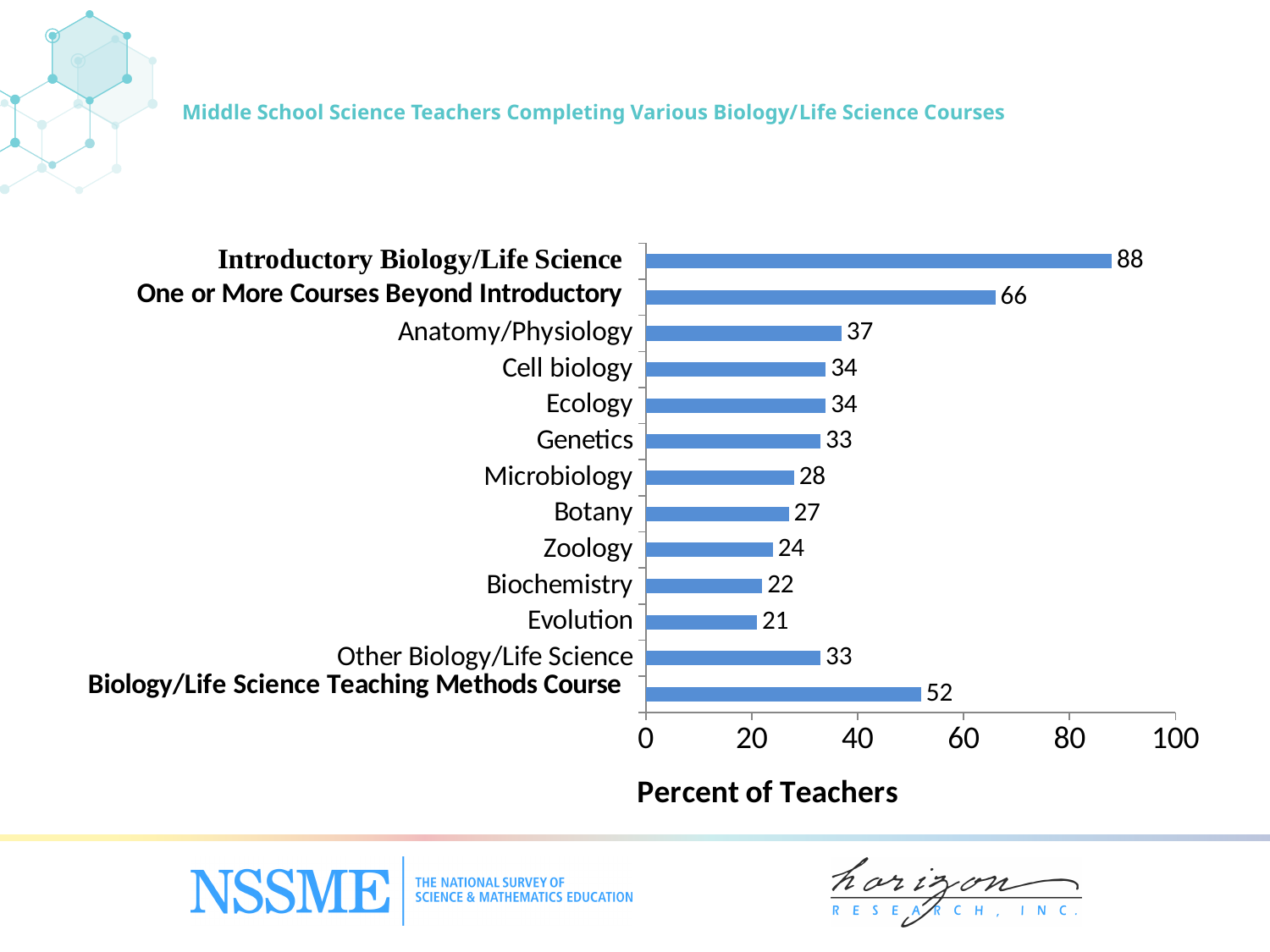
Which course has the lowest percent of teachers? Evolution What percent of teachers completed a Biology/Life Science Teaching Methods Course? 52 What kind of chart is shown on the slide? bar chart What is the value for Genetics? 33 What percent of middle school science teachers completed Introductory Biology/Life Science? 88 What is the label of the horizontal axis? Percent of Teachers Which course has the highest percent of teachers? Introductory Biology/Life Science How many categories are shown in the chart? 13 What is the difference between the values for Introductory Biology/Life Science and One or More Courses Beyond Introductory? 22 What is the difference between the values for Anatomy/Physiology and Microbiology? 9 Which is larger, the value for Botany or the value for Zoology? Botany Is the value for Biochemistry greater or less than 40? less